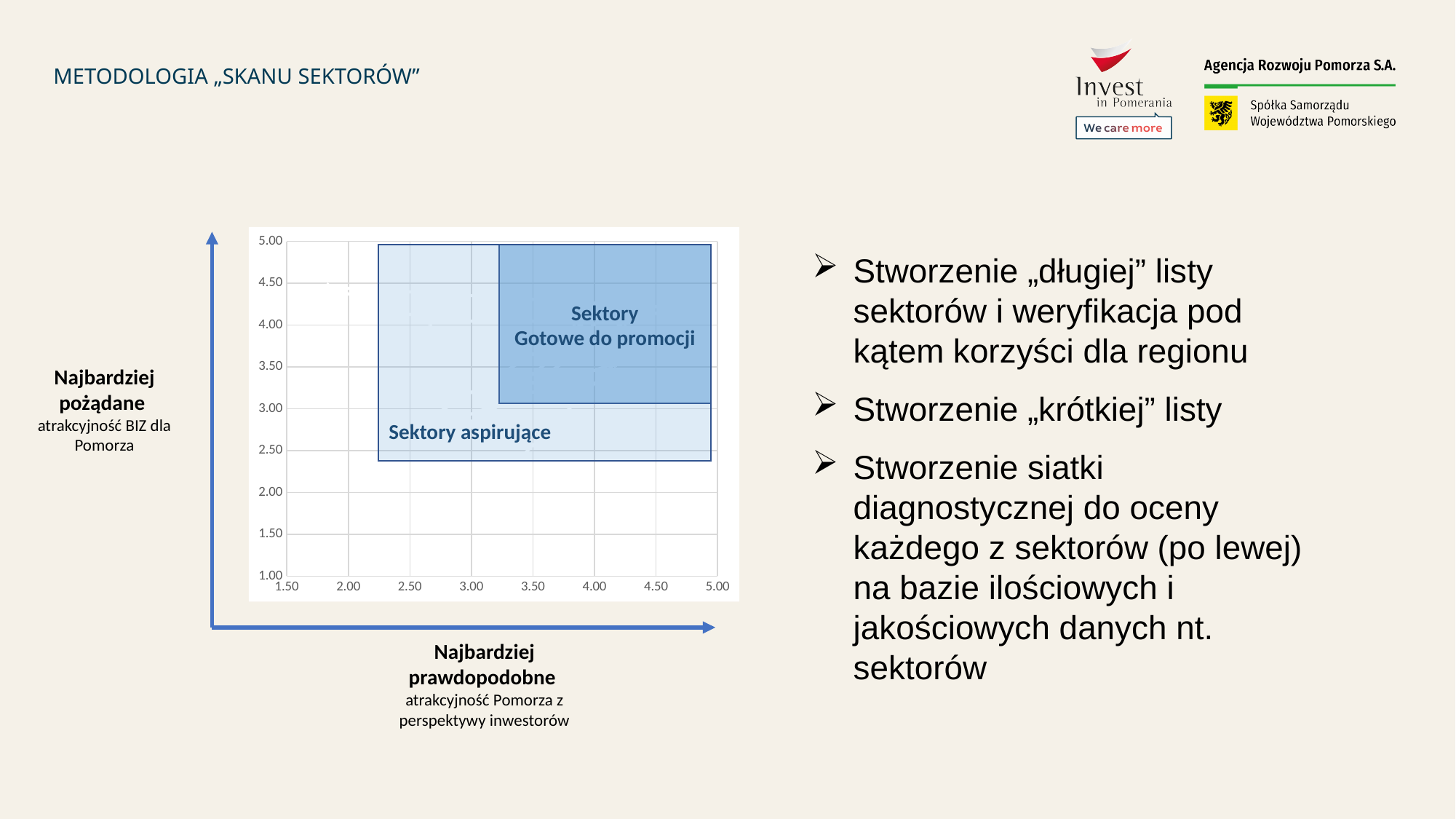
What is the highest value shown on the vertical axis of the chart? 5.00 Is the left edge of the "Sektory Gotowe do promocji" region greater or less than 3.00 on the horizontal axis? greater What is the lowest value shown on the vertical axis of the chart? 1.00 What label is written inside the lighter shaded region of the chart? Sektory aspirujące What is the highest value shown on the horizontal axis of the chart? 5.00 How many shaded regions are drawn on the chart? 2 Is the bottom edge of the "Sektory aspirujące" region greater or less than 2.50 on the vertical axis? less Is the bottom edge of the "Sektory Gotowe do promocji" region greater or less than 2.50 on the vertical axis? greater What is the lowest value shown on the horizontal axis of the chart? 1.50 What label is written inside the darker shaded region of the chart? Sektory Gotowe do promocji